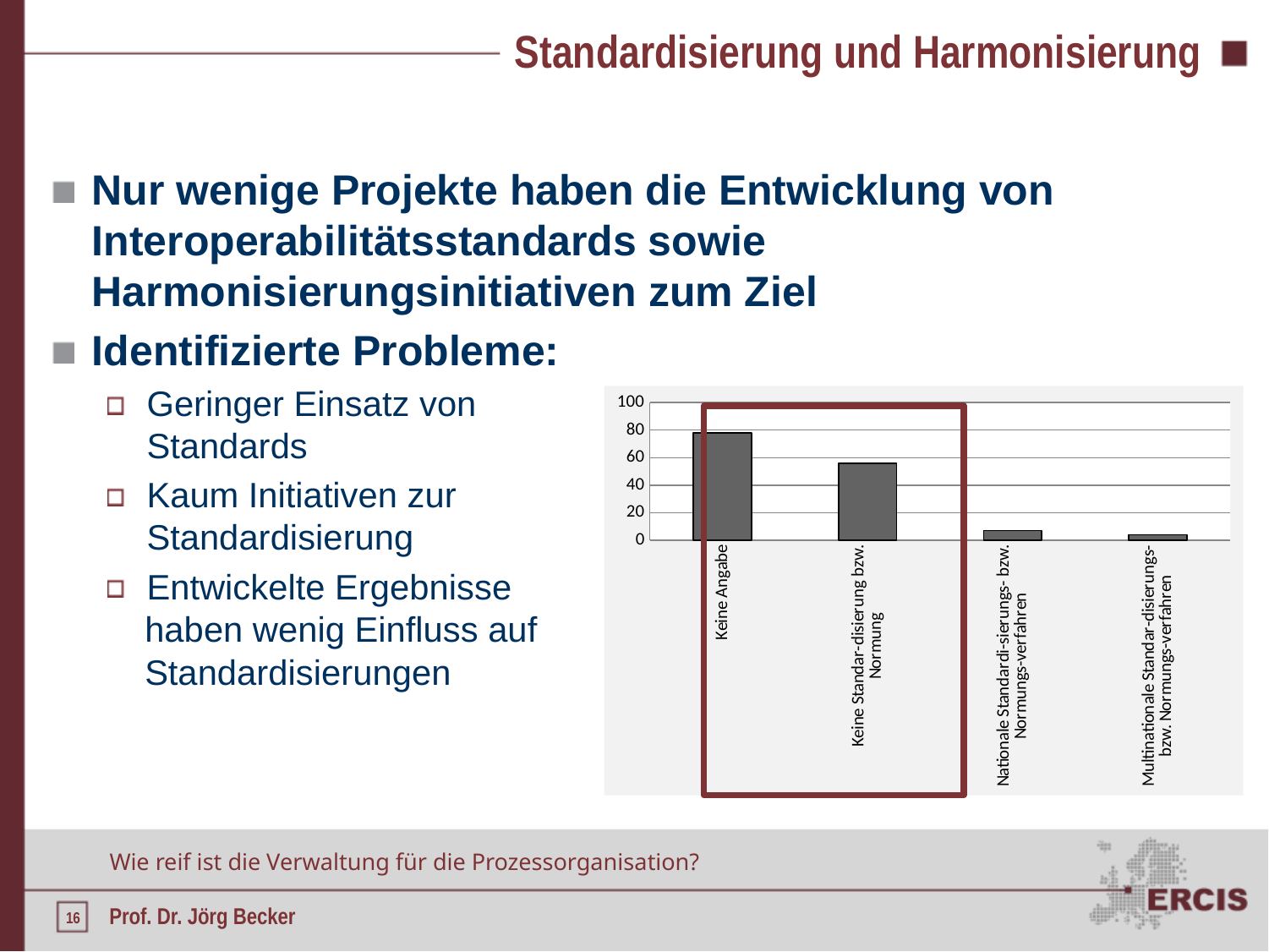
What kind of chart is shown on the slide? bar chart How many categories are shown on the x axis of the chart? 4 Which category has the lowest bar in the chart? Multinationale Standar-disierungs- bzw. Normungs-verfahren Which is larger: the value for Keine Angabe or the value for Keine Standar-disierung bzw. Normung? Keine Angabe Which is larger: the value for Nationale Standardi-sierungs- bzw. Normungs-verfahren or the value for Multinationale Standar-disierungs-verfahren? Nationale Standardi-sierungs- bzw. Normungs-verfahren Do the bar values rise or fall from left to right along the x axis? fall Is the value for Keine Angabe greater or less than 100? less Is the value for Keine Angabe greater or less than 60? greater Is the value for Keine Standar-disierung bzw. Normung greater or less than 40? greater What is the highest value shown on the vertical axis of the chart? 100 Which category has the highest bar in the chart? Keine Angabe